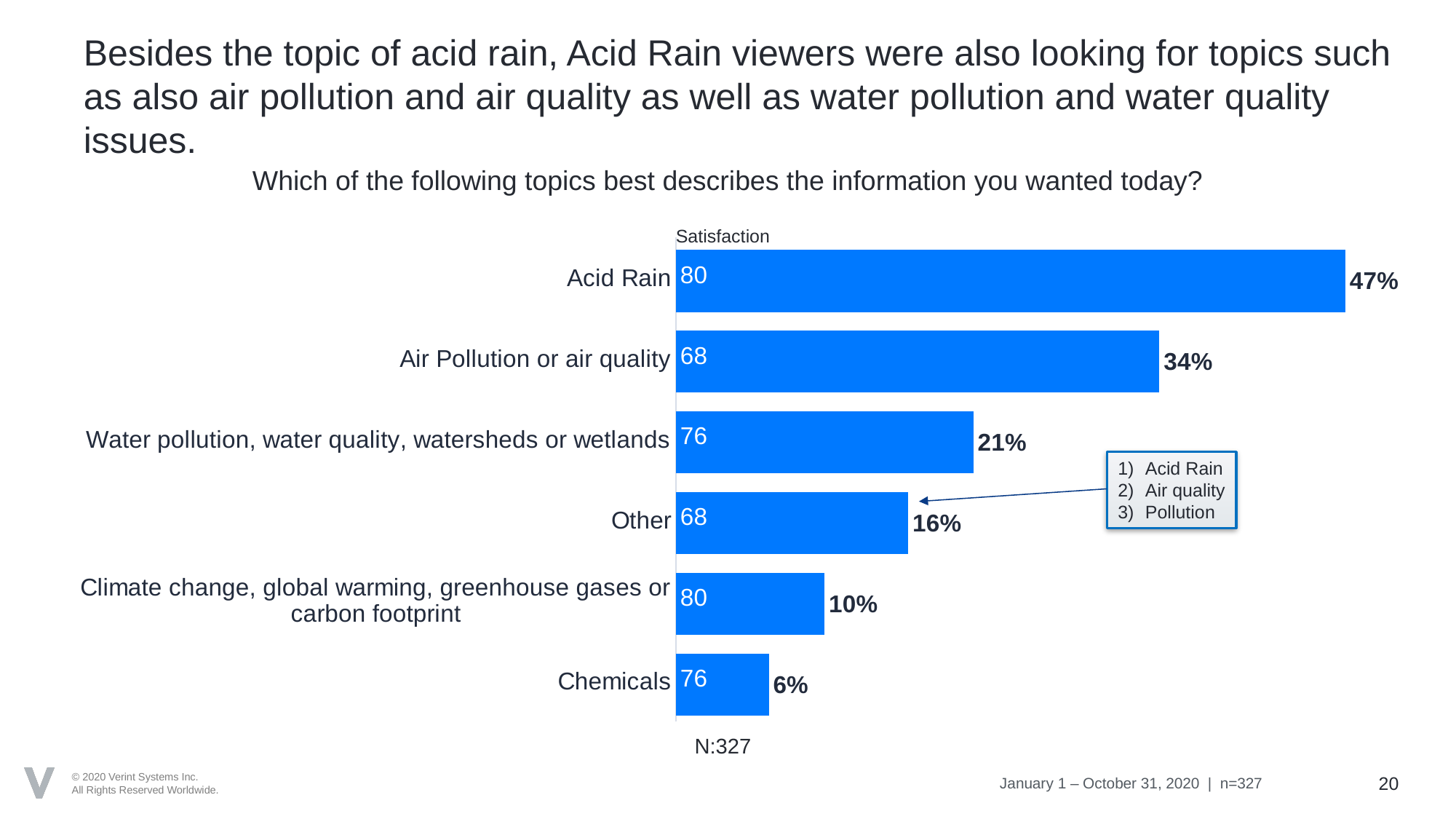
What percentage of viewers selected Acid Rain as the topic best describing the information they wanted? 47% What percentage is shown for Air Pollution or air quality? 34% What is the difference in percentage points between Acid Rain and Air Pollution or air quality? 13 What percentage is shown for Chemicals? 6% Which has a larger percentage, Other or Climate change, global warming, greenhouse gases or carbon footprint? Other Which topic has the highest percentage? Acid Rain What is the satisfaction score shown inside the bar for Water pollution, water quality, watersheds or wetlands? 76 What is the satisfaction score shown inside the bar for Other? 68 What type of chart is used on this slide? Bar chart Which topic has the lowest percentage? Chemicals How many topic categories are shown in the chart? 6 What sample size (N) is shown below the chart? N:327